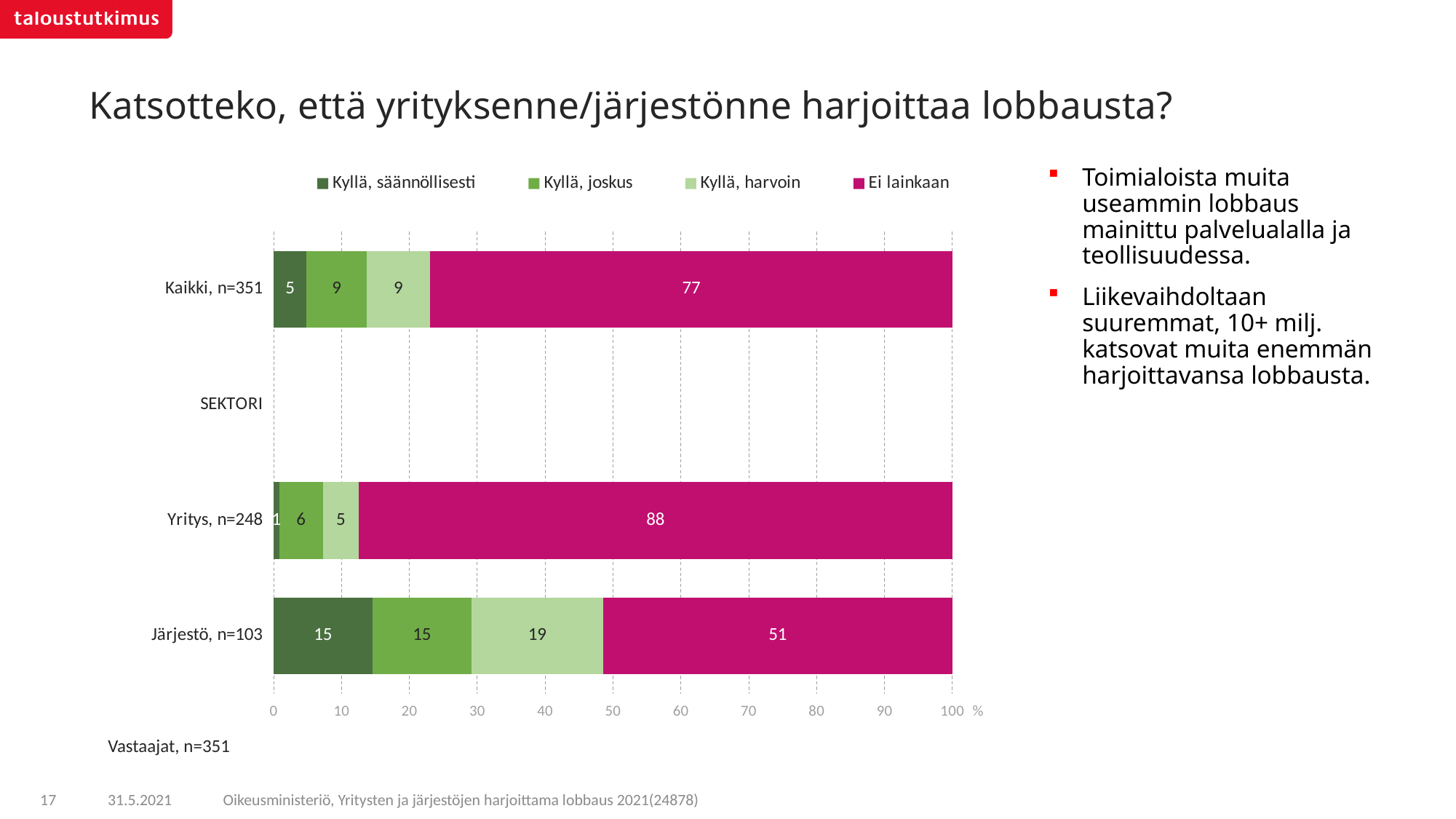
What is the value of "Ei lainkaan" for Kaikki, n=351? 77 Which is larger: the "Kyllä, joskus" value for Kaikki, n=351 or for Järjestö, n=103? Järjestö, n=103 What is the total of the stacked bar for Järjestö, n=103? 100 Which category has the lowest value for "Kyllä, säännöllisesti"? Yritys, n=248 What is the value of "Kyllä, harvoin" for Järjestö, n=103? 19 What kind of chart is shown on the slide? Stacked bar chart What is the difference between the "Ei lainkaan" values for Yritys, n=248 and Järjestö, n=103? 37 What is the value of "Kyllä, säännöllisesti" for Yritys, n=248? 1 How many series does the legend list? 4 What is the value of "Ei lainkaan" for Yritys, n=248? 88 Is the "Ei lainkaan" value for Järjestö, n=103 greater or less than 60? less Which category has the highest value for "Ei lainkaan"? Yritys, n=248